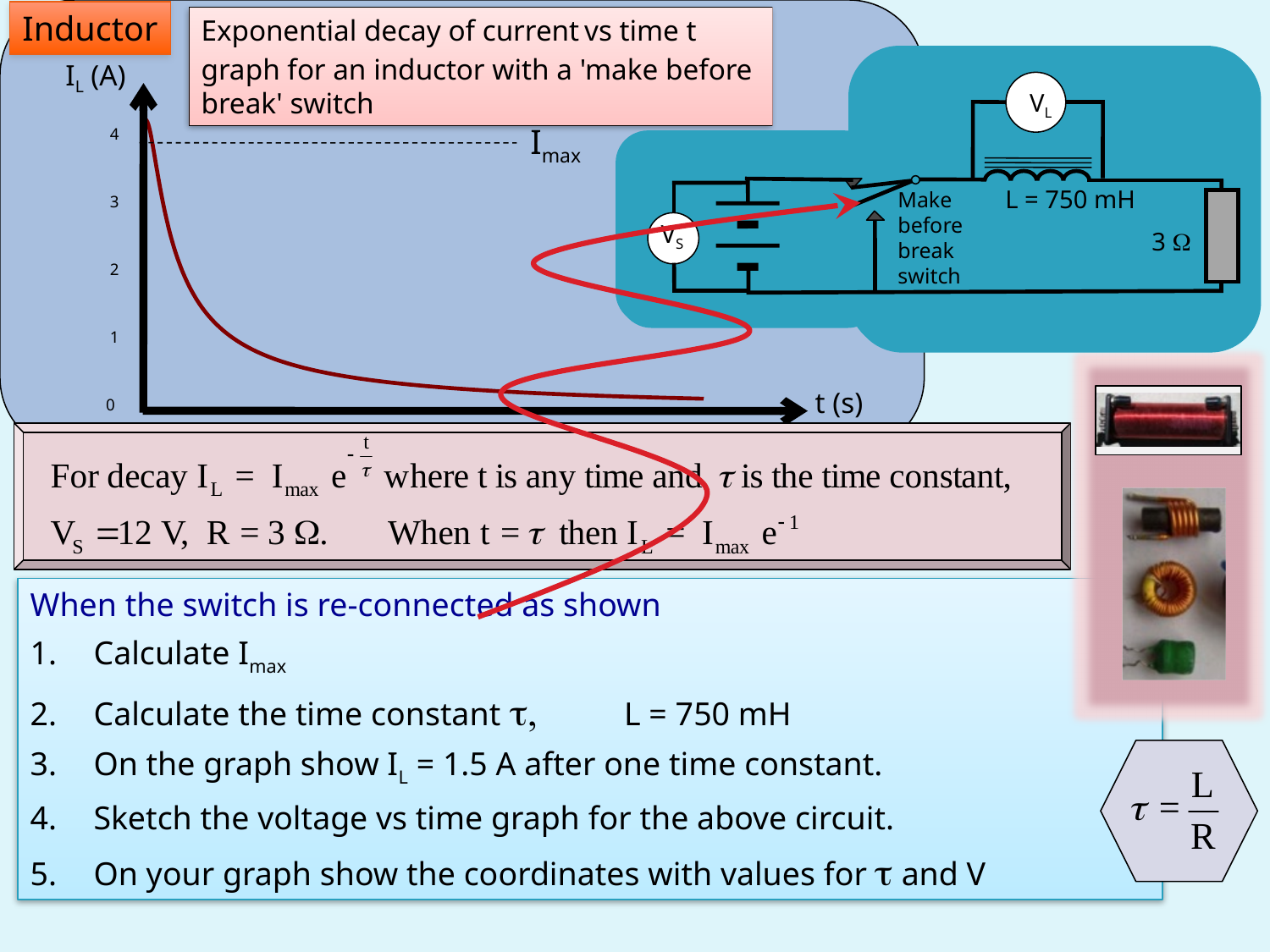
Does the current I_L rise or fall as time t increases along the x axis? fall Is the starting value of the current curve at t = 0 greater or less than 3? greater What value on the vertical axis does the dashed I_max line correspond to? 4 What is the lowest value labelled on the vertical axis of the graph? 0 How many numbered tick labels are shown on the vertical axis of the graph? 5 What is the highest value labelled on the vertical axis of the graph? 4 What is the label of the vertical axis of the graph? I_L (A) What is the label of the horizontal axis of the graph? t (s) What kind of chart is the graph on the left of the slide? line chart